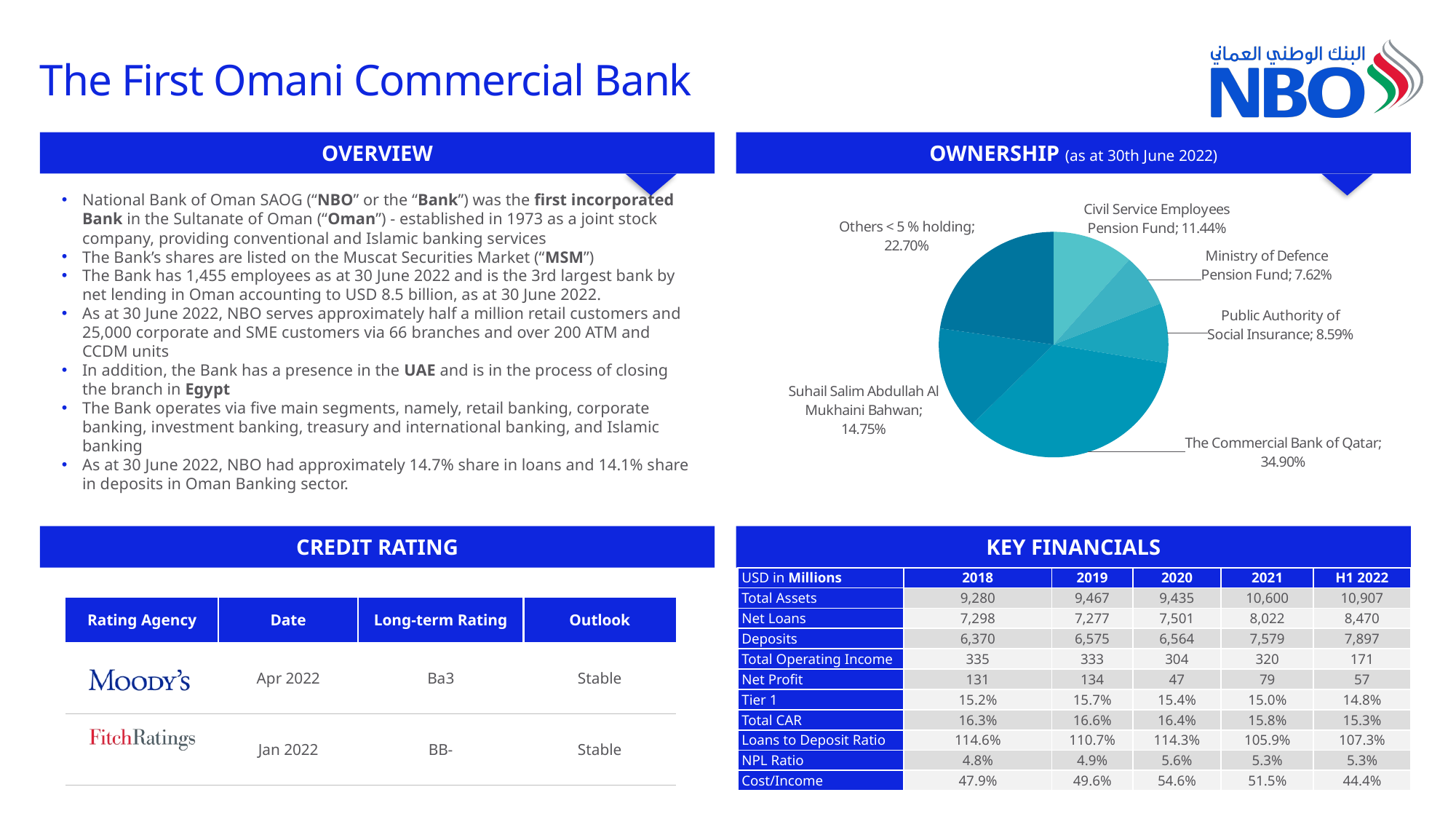
Which shareholder holds the largest share in the ownership pie chart? The Commercial Bank of Qatar What is the combined share of the Civil Service Employees Pension Fund and the Ministry of Defence Pension Fund? 19.06% As at what date is the ownership pie chart reported? 30th June 2022 What share of ownership does The Commercial Bank of Qatar hold? 34.90% Which labelled shareholder holds the smallest share in the ownership pie chart? Ministry of Defence Pension Fund What is the share of the Public Authority of Social Insurance? 8.59% How many slices does the ownership pie chart have? 6 Which is larger: the share of the Public Authority of Social Insurance or the Ministry of Defence Pension Fund? Public Authority of Social Insurance What type of chart is used to show the ownership breakdown? pie chart What percentage is held by Suhail Salim Abdullah Al Mukhaini Bahwan? 14.75% What is the ownership share of the Civil Service Employees Pension Fund? 11.44% What is the difference between the share of The Commercial Bank of Qatar and the share of Others < 5 % holding? 12.20%